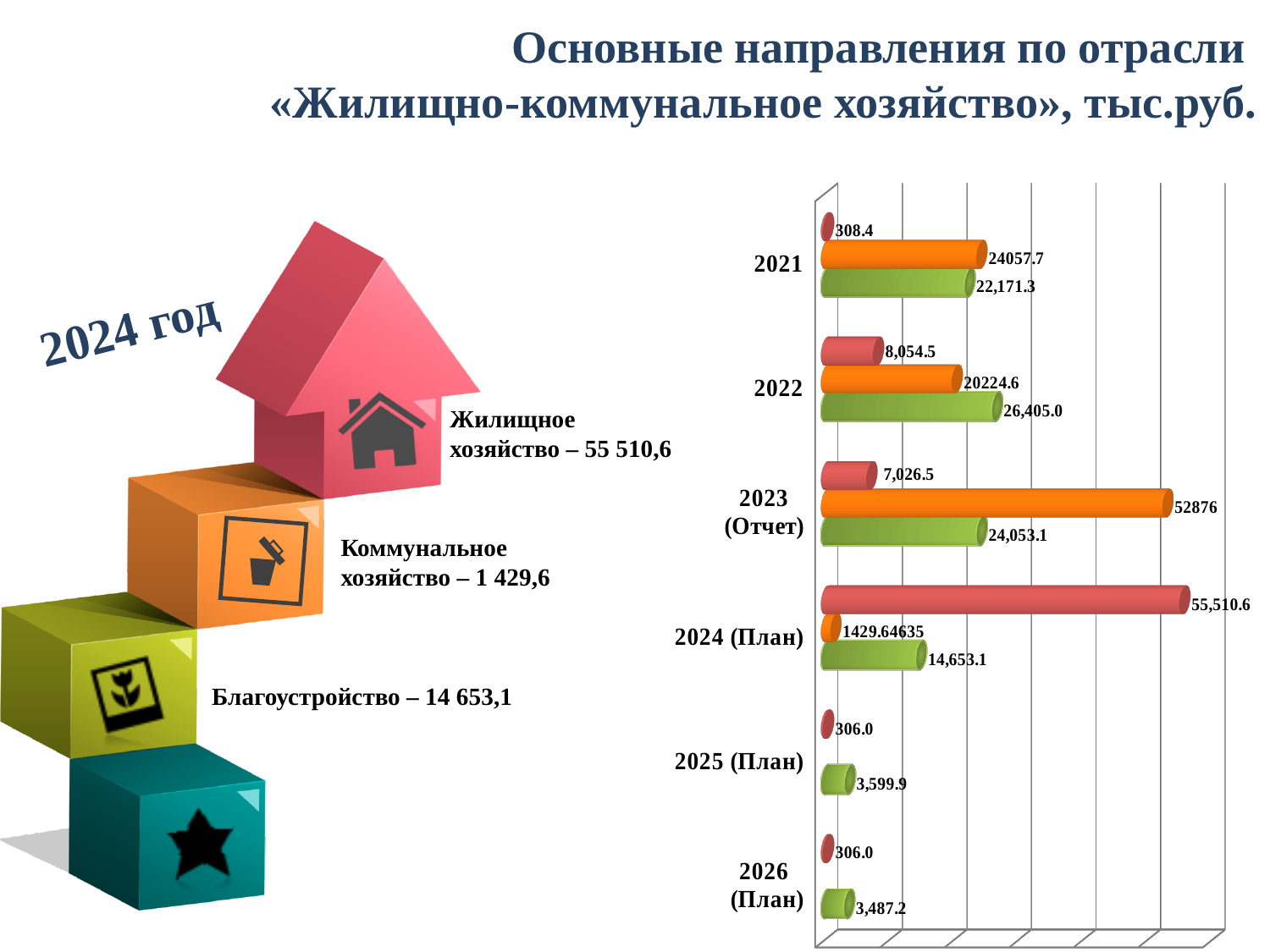
What is the value of the green bar for 2025 (План)? 3,599.9 Which category has the largest orange bar? 2023 (Отчет) What is the value of the green bar for 2022? 26,405.0 For 2021, which is larger: the orange bar or the green bar? the orange bar Which category has the largest red bar? 2024 (План) What kind of chart is shown on the slide? bar chart Which category has the smallest green bar? 2026 (План) How many categories are shown on the chart's vertical axis? 6 What is the difference between the green bar values for 2022 and 2021? 4,233.7 What is the value of the red bar for 2024 (План)? 55,510.6 What is the value of the orange bar for 2023 (Отчет)? 52876 What is the difference between the red bar values for 2022 and 2023 (Отчет)? 1,028.0